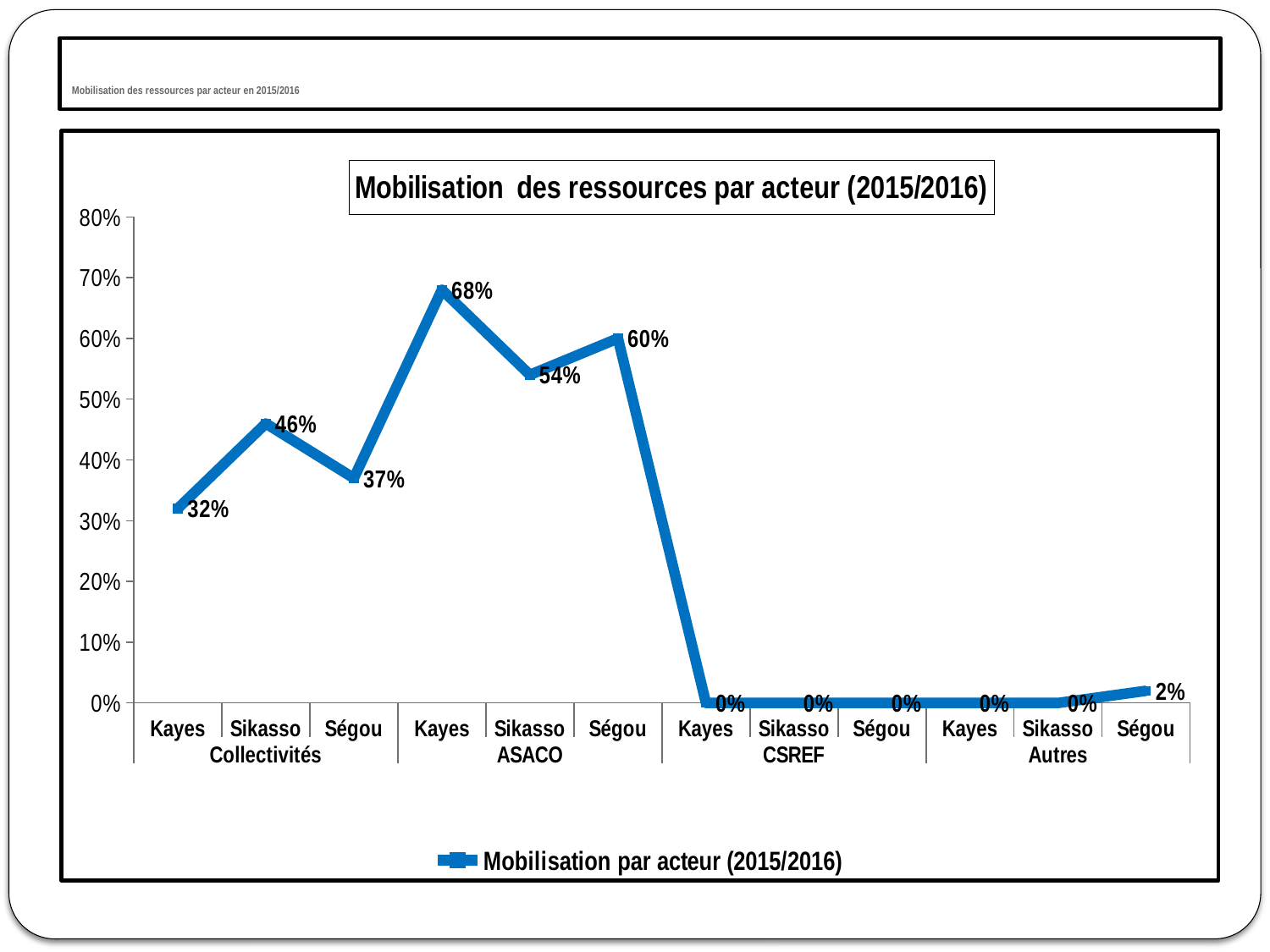
What is the value for Sikasso under ASACO? 54% What is the value for Ségou under Autres? 2% What is the title of the chart? Mobilisation des ressources par acteur (2015/2016) How many data points are plotted on the chart? 12 Is the value for Kayes under ASACO greater or less than 60%? greater What is the value for Kayes under Collectivités? 32% What is the difference between the values for Sikasso under Collectivités and Ségou under Collectivités? 9% Which category has the highest value? Kayes (ASACO) What is the difference between the values for Kayes under ASACO and Ségou under ASACO? 8% Which is larger, the value for Ségou under ASACO or the value for Sikasso under Collectivités? Ségou under ASACO What kind of chart is shown? line chart How many series does the legend list? 1